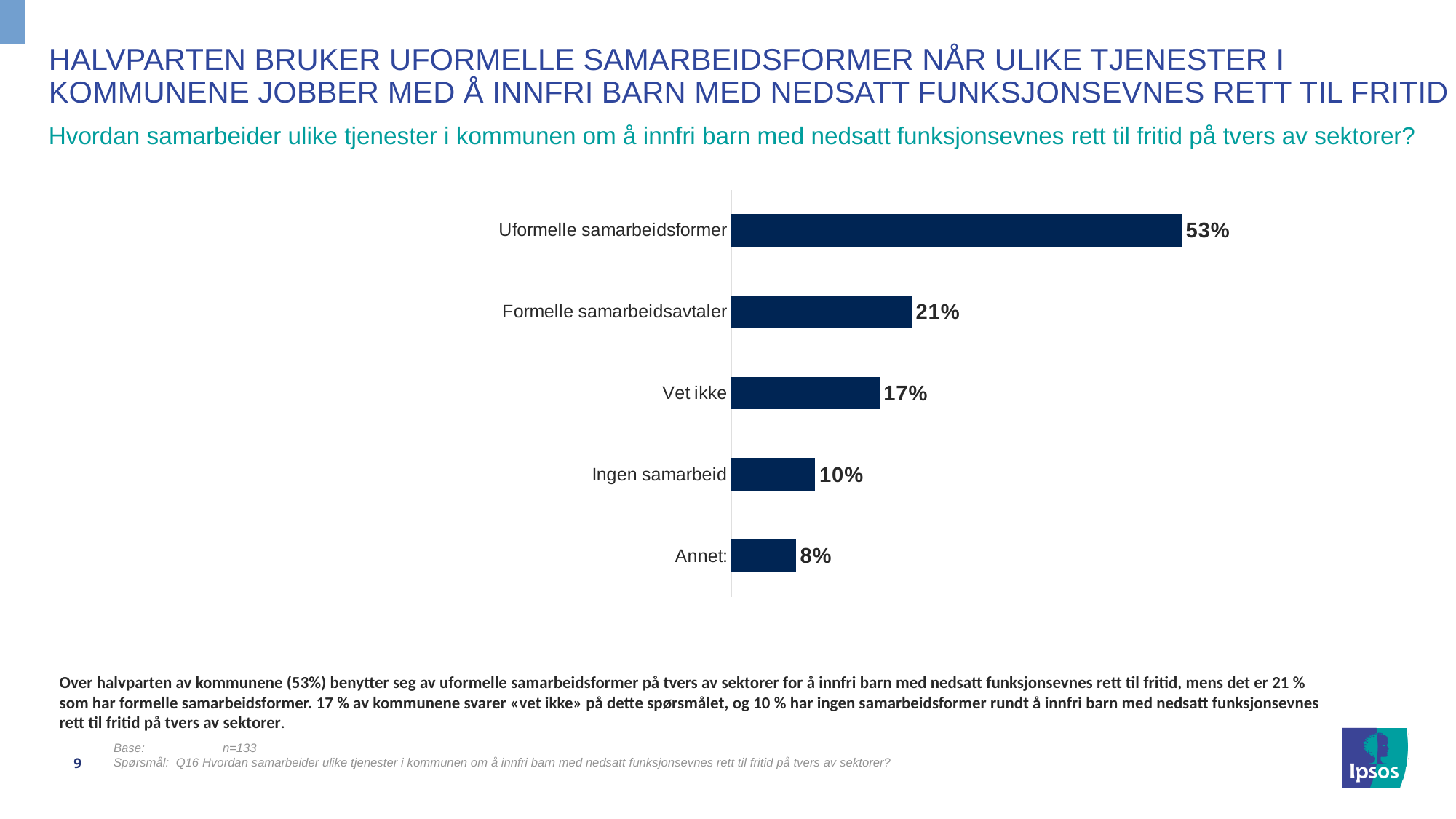
What is the value for Annet:? 8% What is the difference between the values for Uformelle samarbeidsformer and Formelle samarbeidsavtaler? 32% What is the difference between the values for Ingen samarbeid and Annet:? 2% Which category has the lowest value? Annet: Which category has the highest value? Uformelle samarbeidsformer Which is larger, the value for Vet ikke or the value for Ingen samarbeid? Vet ikke What is the value for Uformelle samarbeidsformer? 53% What is the value for Ingen samarbeid? 10% What kind of chart is shown on the slide? Bar chart What is the value for Formelle samarbeidsavtaler? 21% How many categories are shown in the chart? 5 What is the value for Vet ikke? 17%